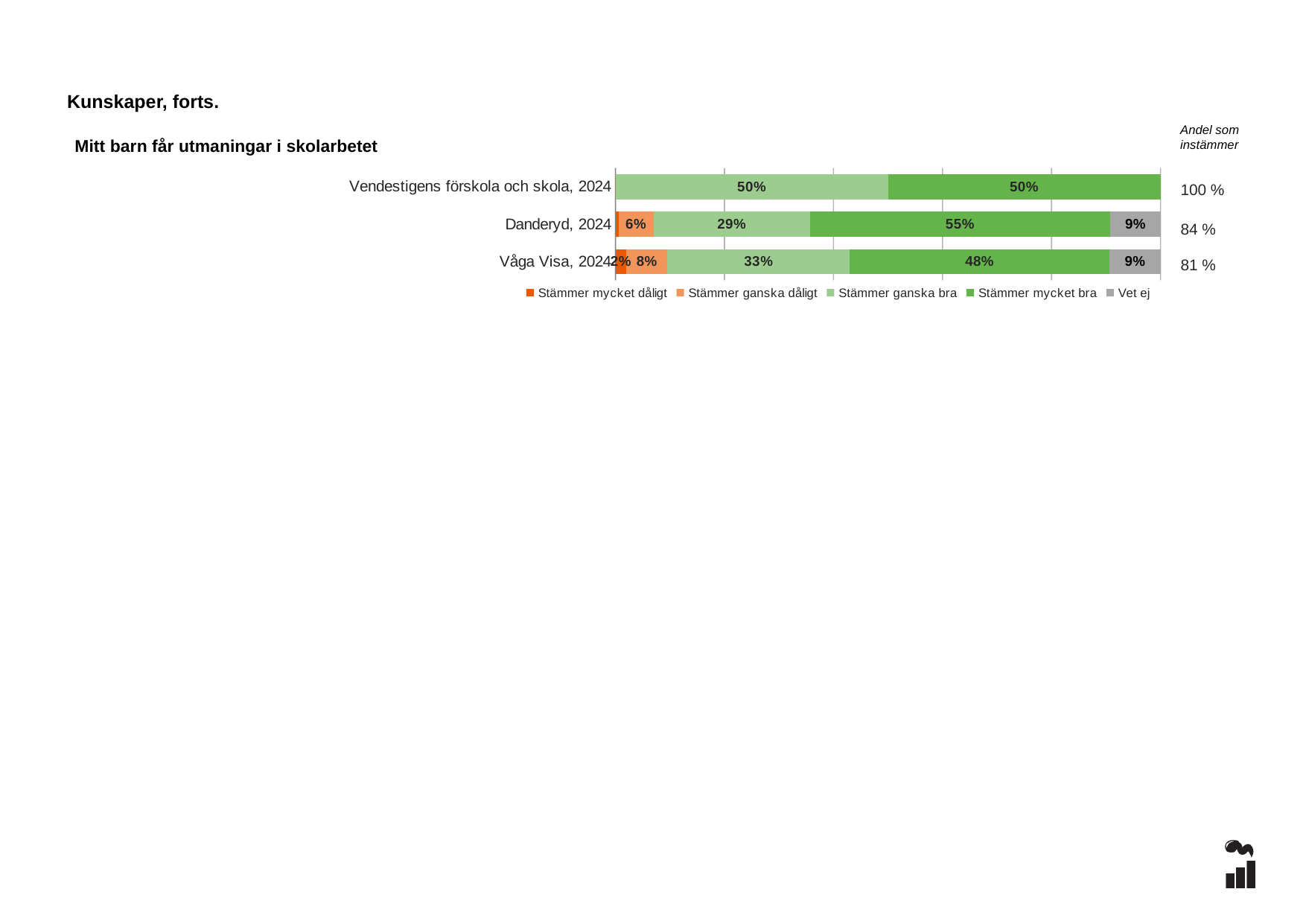
What is the "Andel som instämmer" value shown for Vendestigens förskola och skola, 2024? 100 % What is the difference between the "Stämmer mycket bra" shares of Danderyd, 2024 and Våga Visa, 2024? 7% How many series does the legend list? 5 What is the "Vet ej" share for Danderyd, 2024? 9% What percentage of respondents for Danderyd, 2024 answered "Stämmer mycket bra"? 55% Which is larger: the "Stämmer ganska dåligt" share for Danderyd, 2024 or for Våga Visa, 2024? Våga Visa, 2024 What is the title of the chart? Mitt barn får utmaningar i skolarbetet How many categories (bars) are shown in the chart? 3 Which category has the highest "Stämmer mycket bra" share? Danderyd, 2024 Which category has the lowest "Andel som instämmer" value? Våga Visa, 2024 What percentage of respondents for Våga Visa, 2024 answered "Stämmer ganska bra"? 33% What kind of chart is shown on the slide? Stacked bar chart